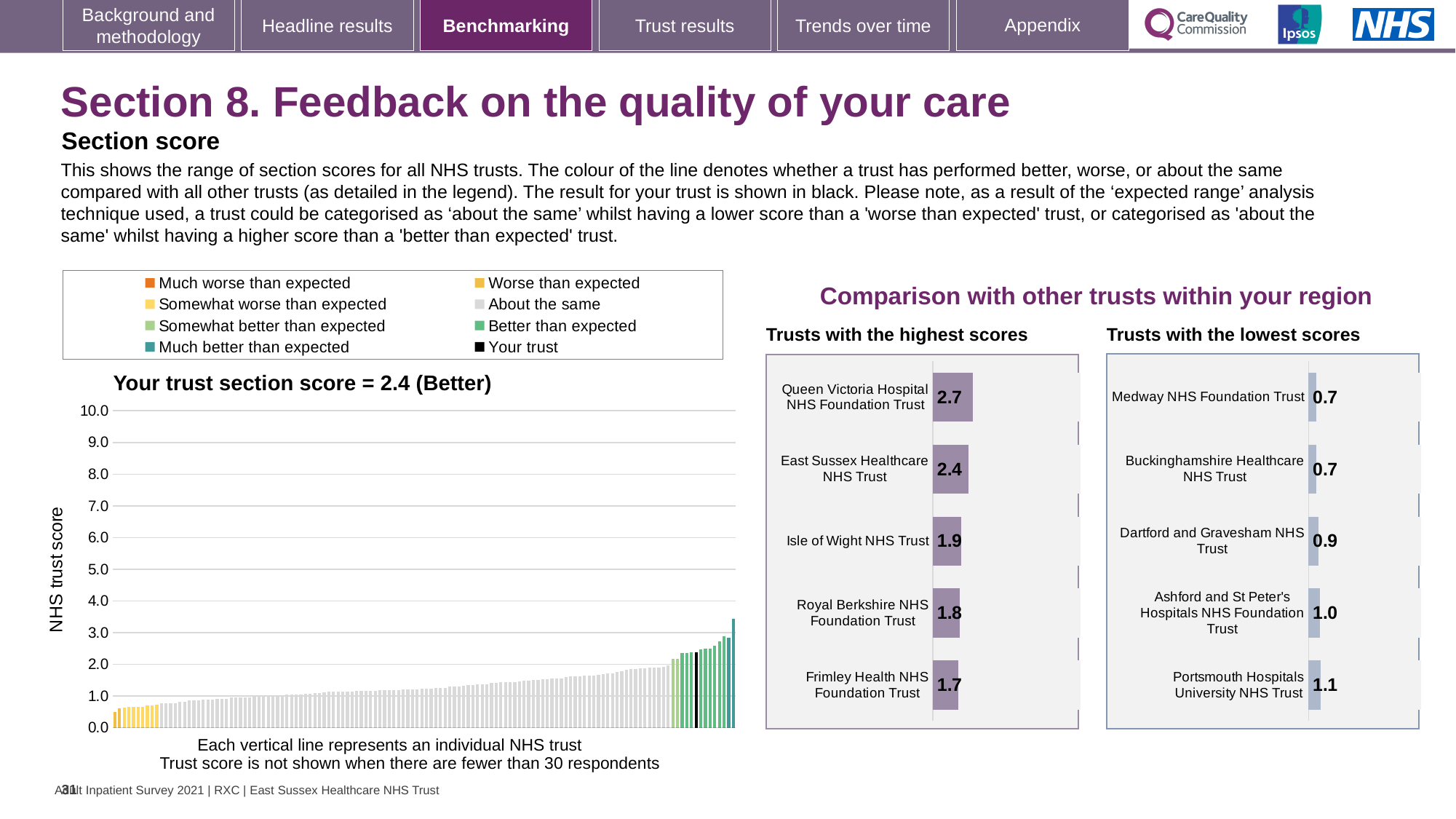
In the 'Trusts with the highest scores' chart, which trust has the highest score? Queen Victoria Hospital NHS Foundation Trust How many entries does the legend above the 'Your trust section score' chart list? 8 In the 'Trusts with the lowest scores' chart, which trust has the highest score shown? Portsmouth Hospitals University NHS Trust In the 'Trusts with the highest scores' chart, what is the difference between the scores of Queen Victoria Hospital NHS Foundation Trust and Frimley Health NHS Foundation Trust? 1.0 In the 'Your trust section score = 2.4 (Better)' chart, is the tallest bar greater or less than 4.0? less In the 'Trusts with the highest scores' chart, what is the score for Queen Victoria Hospital NHS Foundation Trust? 2.7 What kind of chart is the 'Your trust section score = 2.4 (Better)' chart? bar chart How many trusts are listed in the 'Trusts with the lowest scores' chart? 5 According to the title of the left-hand chart, what is your trust's section score? 2.4 (Better) In the 'Trusts with the highest scores' chart, which has the larger score: Isle of Wight NHS Trust or Royal Berkshire NHS Foundation Trust? Isle of Wight NHS Trust In the 'Your trust section score = 2.4 (Better)' chart, do the bars rise or fall from left to right? rise In the 'Trusts with the lowest scores' chart, what is the score for Dartford and Gravesham NHS Trust? 0.9